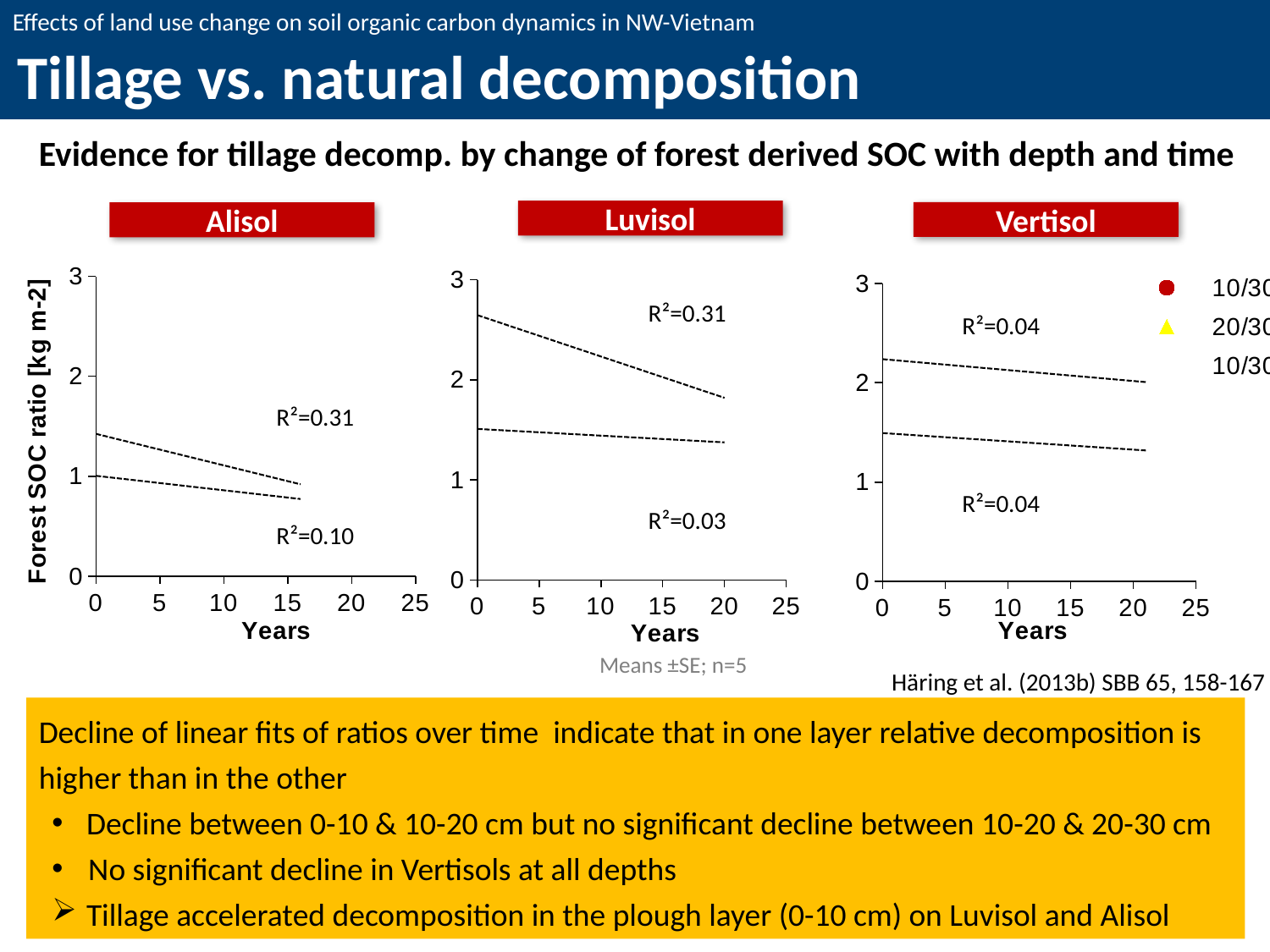
In the Luvisol chart, what R² value is shown for the lower dashed line? R²=0.03 How many charts are shown on the slide? 3 In the Luvisol chart, do the dashed lines rise or fall as Years increase? fall In the Luvisol chart, is the value of the upper dashed line at 0 years greater or less than 2? greater In the Vertisol chart, what R² value is shown for the upper dashed line? R²=0.04 What is the x-axis label of the Luvisol chart? Years What is the y-axis label of the Alisol chart? Forest SOC ratio [kg m-2] In the Alisol chart, is the value of the upper dashed line at 0 years greater or less than 2? less In the Luvisol chart, what R² value is shown for the upper dashed line? R²=0.31 What is the title of the leftmost chart? Alisol In the Alisol chart, what R² value is shown for the lower dashed line? R²=0.10